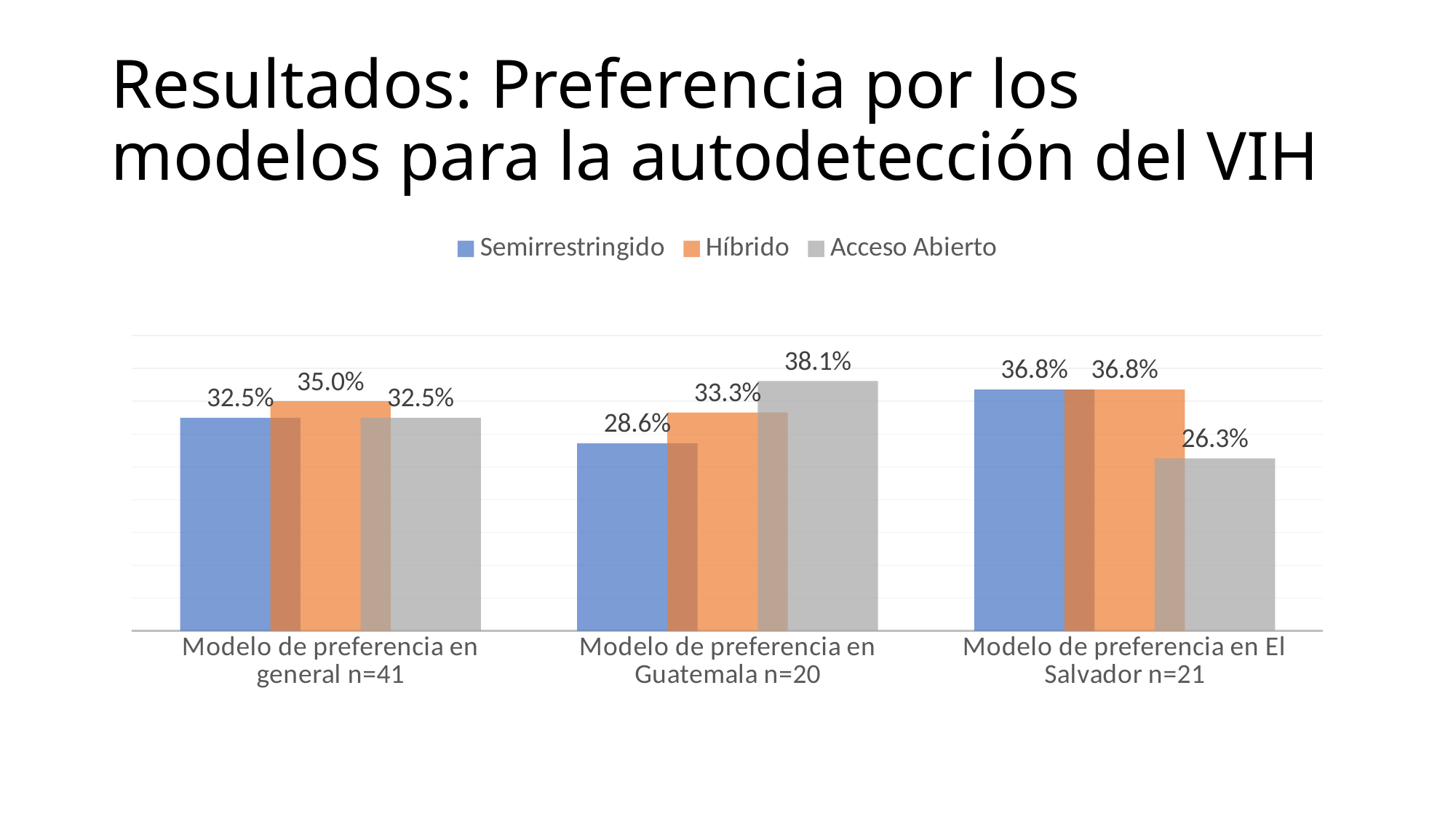
How many series does the legend list? 3 Which series has the highest value in the 'Modelo de preferencia en Guatemala n=20' category? Acceso Abierto Which colour represents the Híbrido series in the legend? Orange What is the value for Semirrestringido in the 'Modelo de preferencia en El Salvador n=21' category? 36.8% What is the value for Semirrestringido in the 'Modelo de preferencia en Guatemala n=20' category? 28.6% How many categories are shown on the x axis? 3 What is the difference between the Acceso Abierto value in Guatemala n=20 and the Acceso Abierto value in El Salvador n=21? 11.8% Which is larger: the Híbrido value in Guatemala n=20 or the Híbrido value in El Salvador n=21? El Salvador n=21 What kind of chart is shown on the slide? Bar chart Which series has the lowest value in the 'Modelo de preferencia en El Salvador n=21' category? Acceso Abierto What is the value for Híbrido in the 'Modelo de preferencia en general n=41' category? 35.0% What is the value for Acceso Abierto in the 'Modelo de preferencia en Guatemala n=20' category? 38.1%